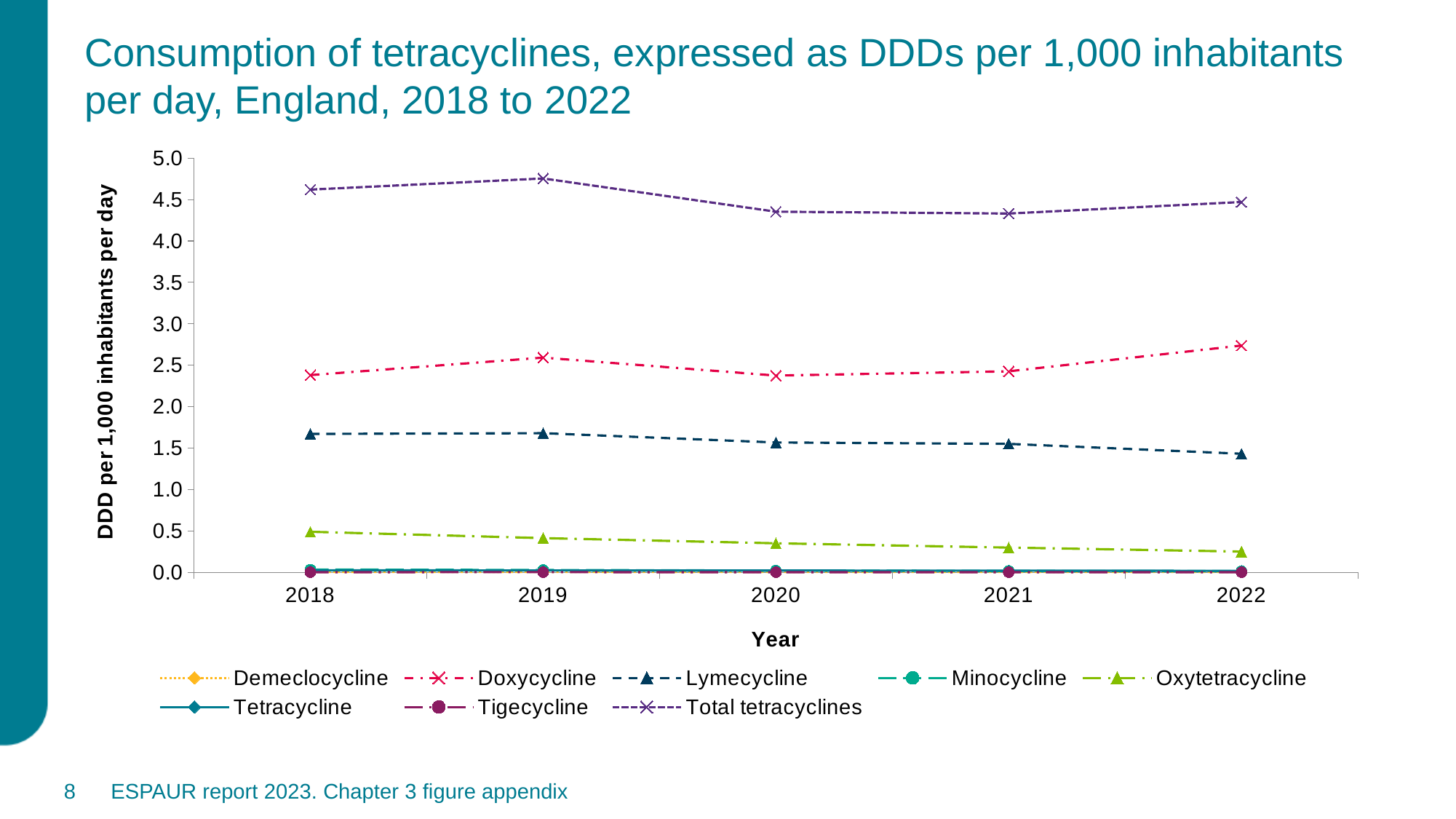
What kind of chart is shown on the slide? line chart How many years are plotted along the x axis? 5 In which year is the Oxytetracycline value lowest? 2022 Which series has the highest value in 2022? Total tetracyclines In which year is the Doxycycline value highest? 2022 Does the Lymecycline line rise or fall from 2018 to 2022? fall Is the value for Lymecycline in 2022 greater or less than 1.5? less Is the value for Doxycycline in 2022 greater or less than 2.5? greater In which year is the Total tetracyclines value highest? 2019 How many series does the legend list? 8 Which is larger in 2020, the value for Doxycycline or the value for Lymecycline? Doxycycline Is the value for Total tetracyclines in 2019 greater or less than 4.5? greater